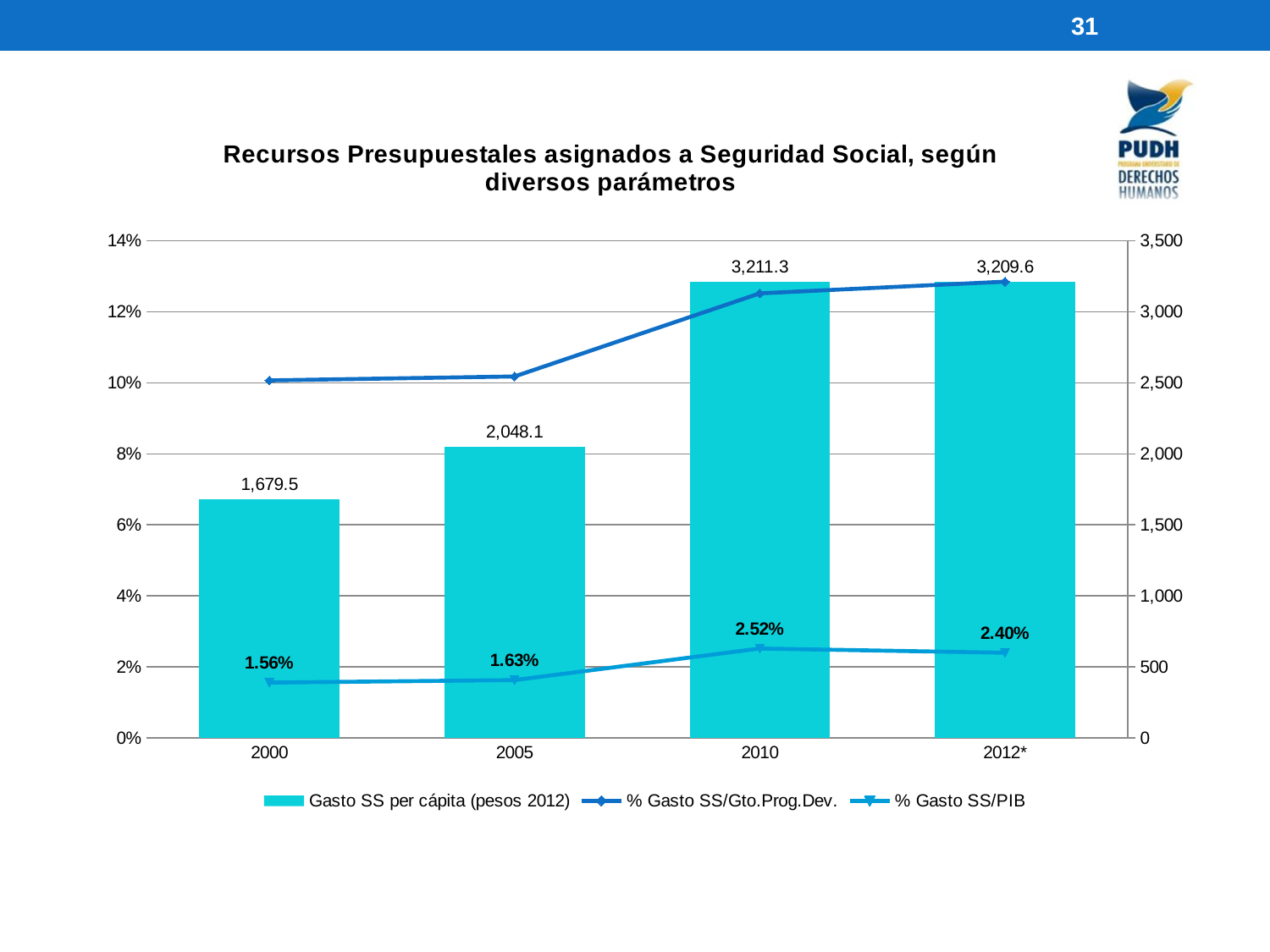
What is the % Gasto SS/PIB value for 2012*? 2.40% Is the % Gasto SS/Gto.Prog.Dev. value for 2010 greater or less than 12%? greater What is the value of Gasto SS per cápita (pesos 2012) for 2000? 1,679.5 Is the Gasto SS per cápita (pesos 2012) value larger in 2005 or in 2000? 2005 How many series does the legend list? 3 Does the % Gasto SS/Gto.Prog.Dev. line rise or fall from 2000 to 2012*? rise What is the difference in Gasto SS per cápita (pesos 2012) between 2005 and 2000? 368.6 What is the % Gasto SS/PIB value for 2005? 1.63% Which year has the highest % Gasto SS/PIB value? 2010 Which year has the lowest Gasto SS per cápita (pesos 2012)? 2000 What is the value of Gasto SS per cápita (pesos 2012) for 2010? 3,211.3 How many years are shown on the x axis? 4